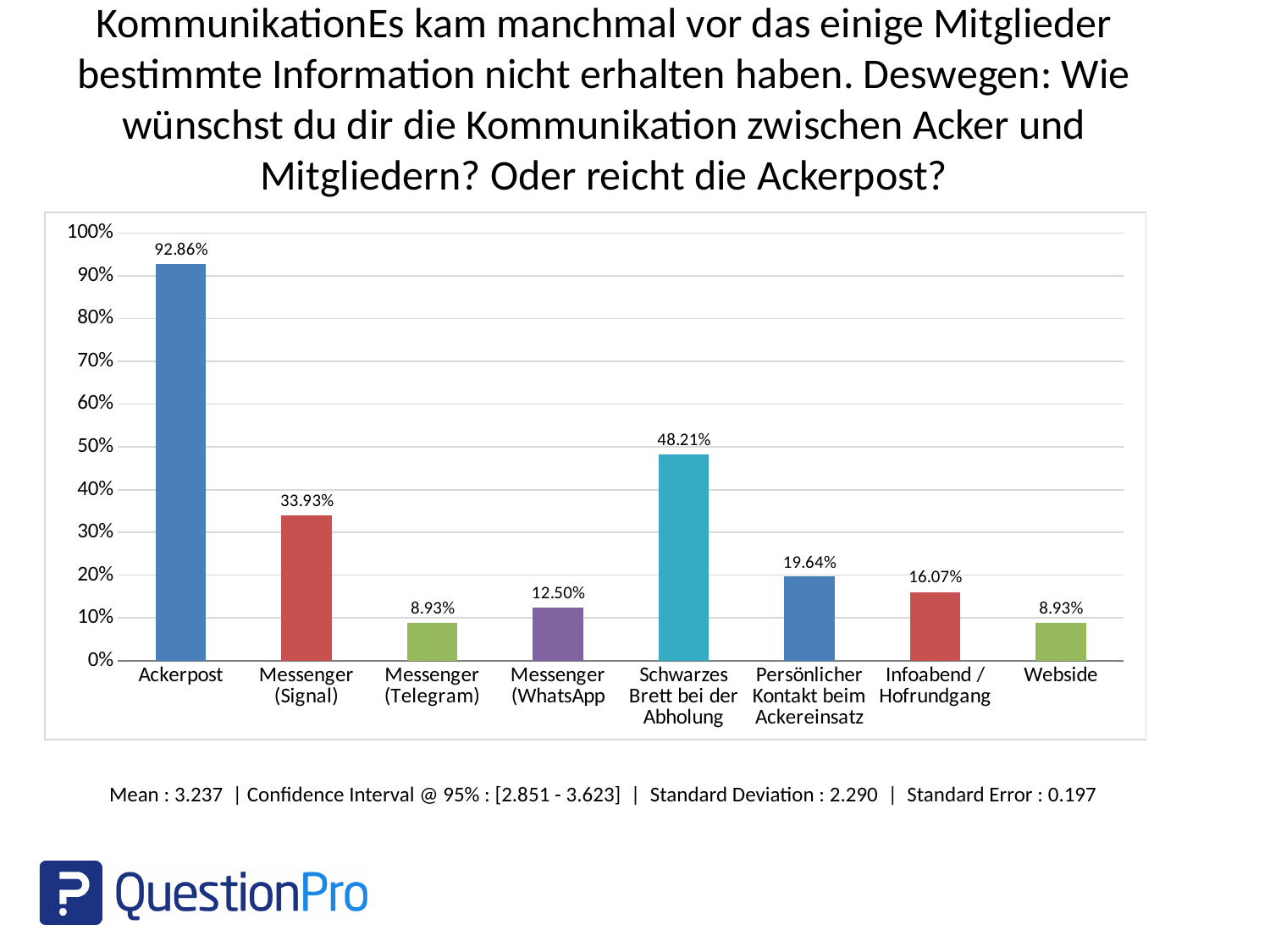
What kind of chart is shown on the slide? bar chart Which is larger, the value for Messenger (Signal) or the value for Persönlicher Kontakt beim Ackereinsatz? Messenger (Signal) Is the value for Messenger (WhatsApp) greater or less than 20%? less What is the value for Messenger (Signal)? 33.93% What is the difference between the values for Persönlicher Kontakt beim Ackereinsatz and Infoabend / Hofrundgang? 3.57% What is the Mean value reported below the chart? 3.237 How many categories are shown on the x axis? 8 What is the value for Ackerpost? 92.86% What is the difference between the values for Ackerpost and Schwarzes Brett bei der Abholung? 44.65% What is the value for Schwarzes Brett bei der Abholung? 48.21% What is the value for Infoabend / Hofrundgang? 16.07% Which category has the highest value? Ackerpost